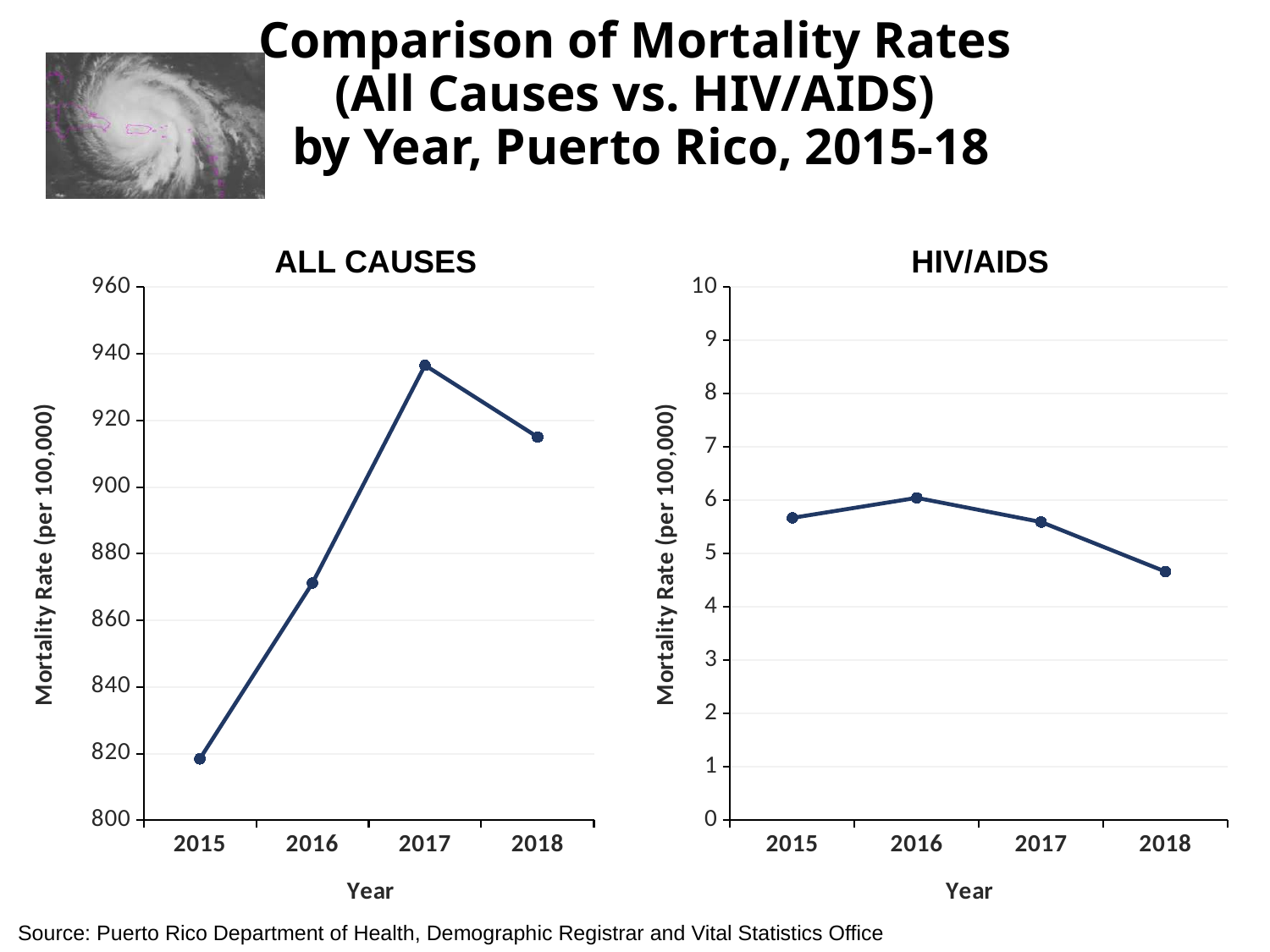
In the ALL CAUSES chart, which year has the larger value, 2017 or 2018? 2017 In the HIV/AIDS chart, which year has the lowest mortality rate? 2018 What kind of chart is the ALL CAUSES chart? line chart In the ALL CAUSES chart, which year has the highest mortality rate? 2017 In the ALL CAUSES chart, is the value for 2016 greater or less than 880? less In the ALL CAUSES chart, which year has the lowest mortality rate? 2015 How many years are plotted in the HIV/AIDS chart? 4 In the ALL CAUSES chart, is the value for 2017 greater or less than 920? greater In the HIV/AIDS chart, is the value for 2018 greater or less than 5? less In the HIV/AIDS chart, which year has the highest mortality rate? 2016 In the HIV/AIDS chart, does the mortality rate rise or fall from 2016 to 2018? fall